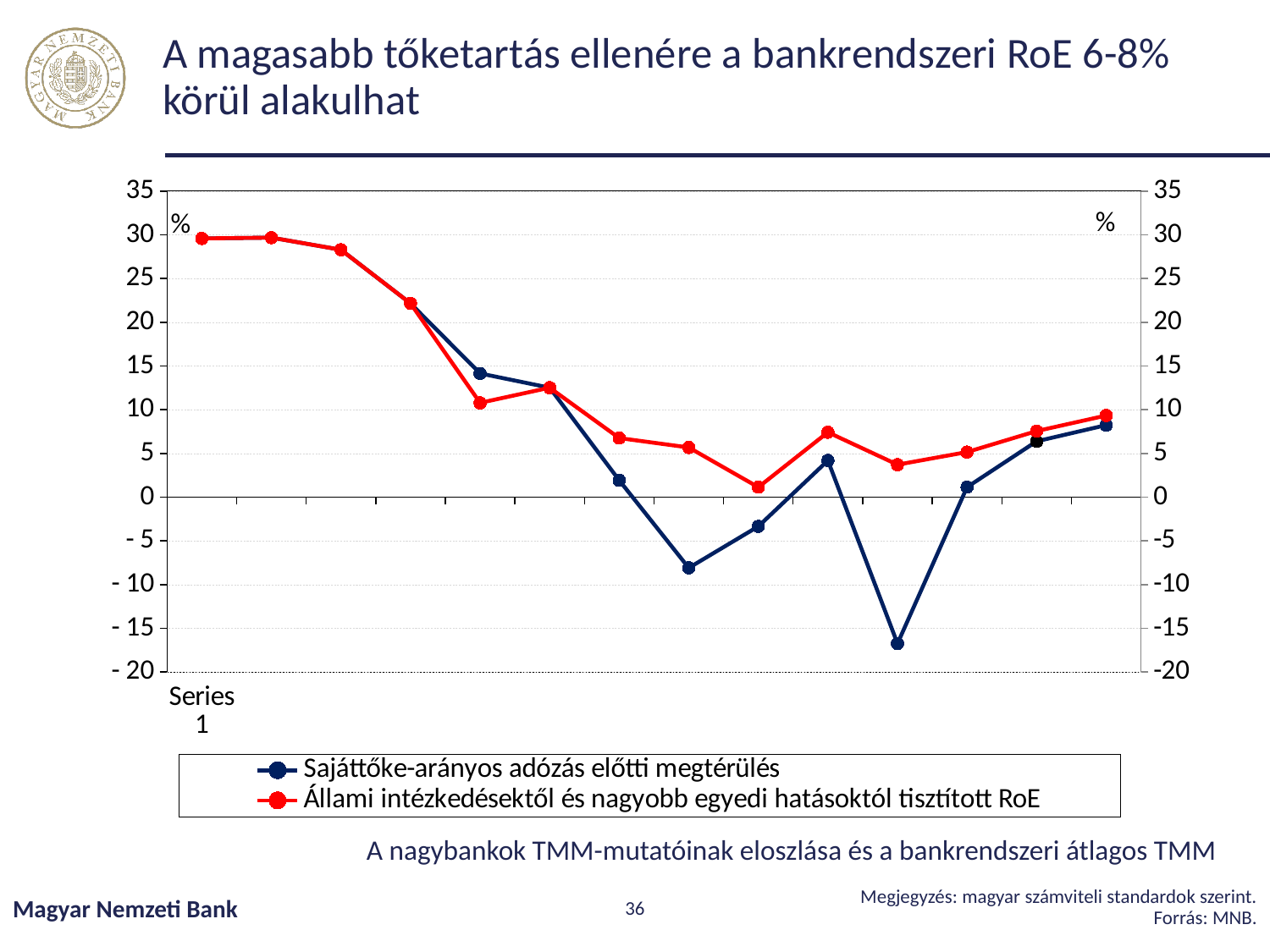
Is the last (rightmost) value of the dark blue series greater or less than 10? less At the point where the dark blue series reaches its lowest value, which series has the higher value? Állami intézkedésektől és nagyobb egyedi hatásoktól tisztított RoE Is the first (leftmost) value of the red series greater or less than 25? greater Is the lowest value of the dark blue series greater or less than -15? less What kind of chart is shown on the slide? line chart Do the values of the red series overall rise or fall from left to right along the x axis? fall How many series does the legend list? 2 How many data points does the red series have? 14 What is the name of the series drawn in dark blue? Sajáttőke-arányos adózás előtti megtérülés What is the highest value shown on the left y axis? 35 What is the name of the series drawn in red? Állami intézkedésektől és nagyobb egyedi hatásoktól tisztított RoE